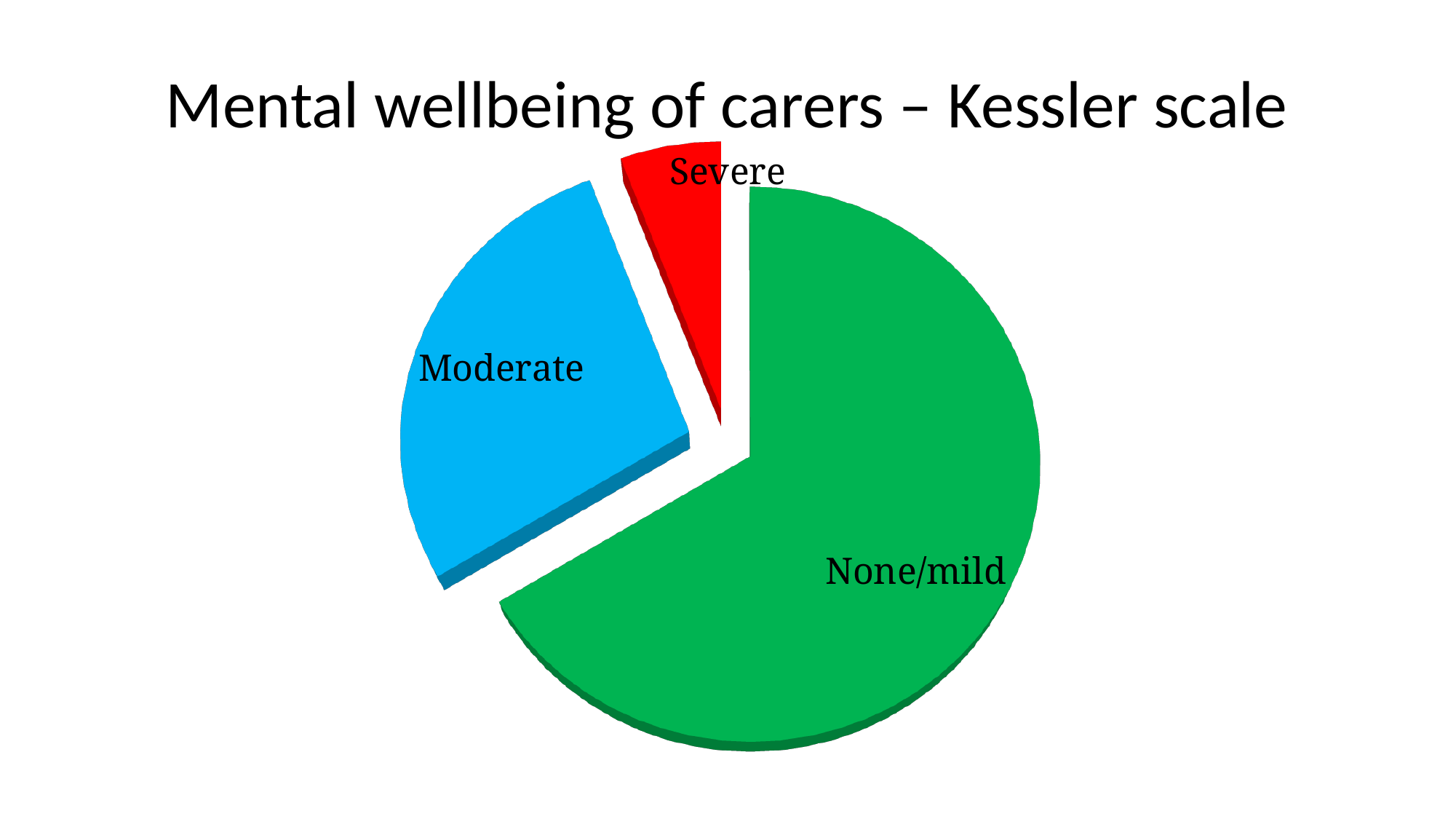
Which category has the smallest slice of the pie? Severe Which slice is larger, None/mild or Moderate? None/mild Does the None/mild slice take up more or less than half of the pie? more What kind of chart is shown on the slide? pie chart How many slices does the pie chart have? 3 What is the title of the chart? Mental wellbeing of carers – Kessler scale Which category has the largest slice of the pie? None/mild What colour is the None/mild slice? green Which slice is larger, Moderate or Severe? Moderate